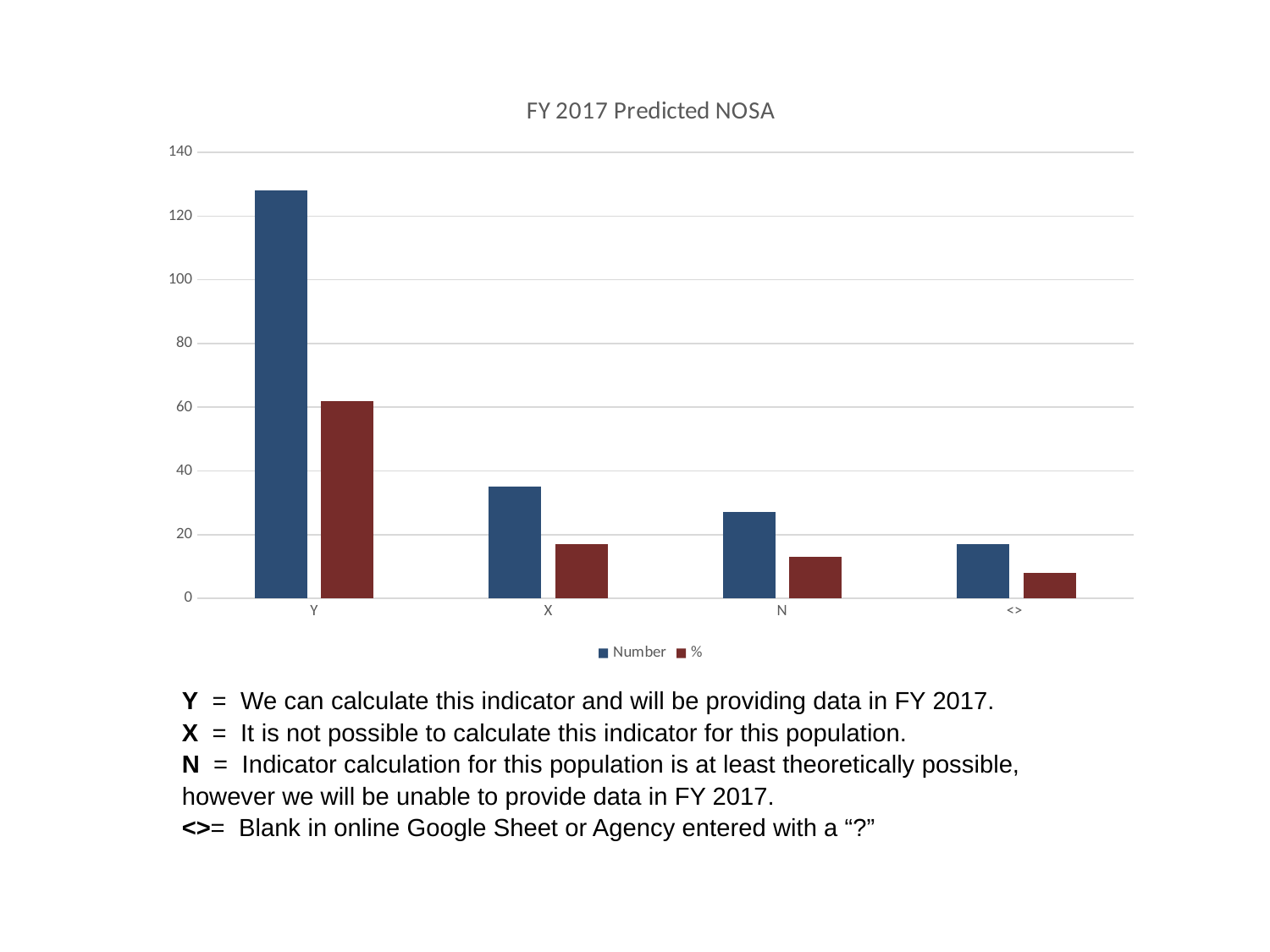
Which category has the lowest Number value? <> Which category has the highest % value? Y What kind of chart is shown on the slide? bar chart What are the two series named in the legend? Number and % Is the % value for Y greater or less than 60? greater How many series does the legend list? 2 How many categories are shown on the x axis? 4 Is the Number value for Y greater or less than 120? greater Which category has the highest Number value? Y Is the Number value for X greater or less than 40? less What is the title of the chart? FY 2017 Predicted NOSA Which is larger, the Number value for X or the Number value for N? X